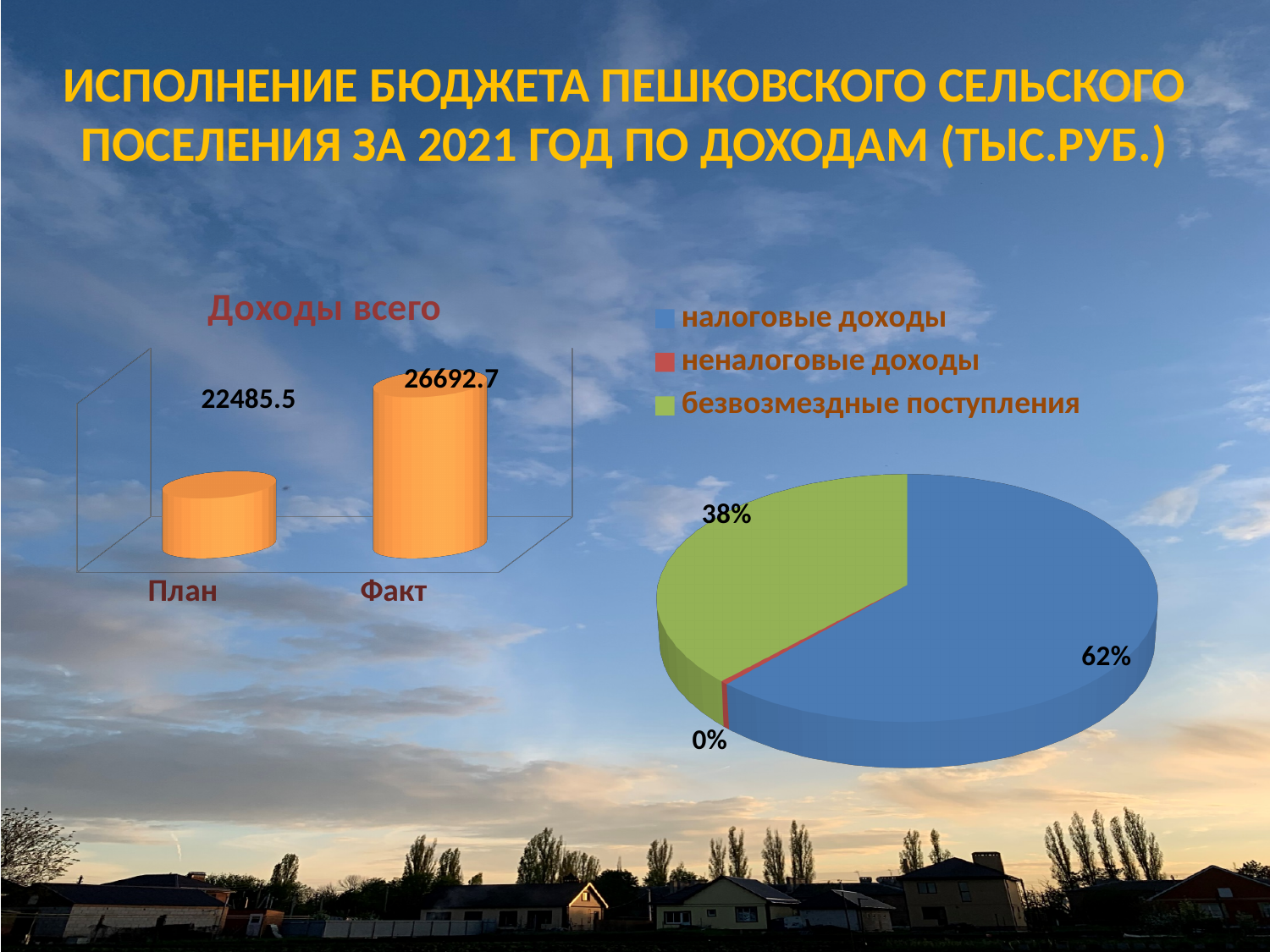
In the 'Доходы всего' chart, what is the difference between Факт and План? 4207.2 In the pie chart on the right, which category has the largest slice? налоговые доходы In the pie chart on the right, what share is shown for безвозмездные поступления? 38% In the 'Доходы всего' chart, what is the value for Факт? 26692.7 In the 'Доходы всего' chart, which category has the lowest value? План In the 'Доходы всего' chart, how many categories are shown? 2 In the pie chart on the right, what share is shown for неналоговые доходы? 0% In the 'Доходы всего' chart, which category has the higher value, План or Факт? Факт In the 'Доходы всего' chart, what is the value for План? 22485.5 What kind of chart is the 'Доходы всего' chart on the left? Bar chart In the pie chart on the right, what share is shown for налоговые доходы? 62% How many entries does the legend of the pie chart on the right list? 3